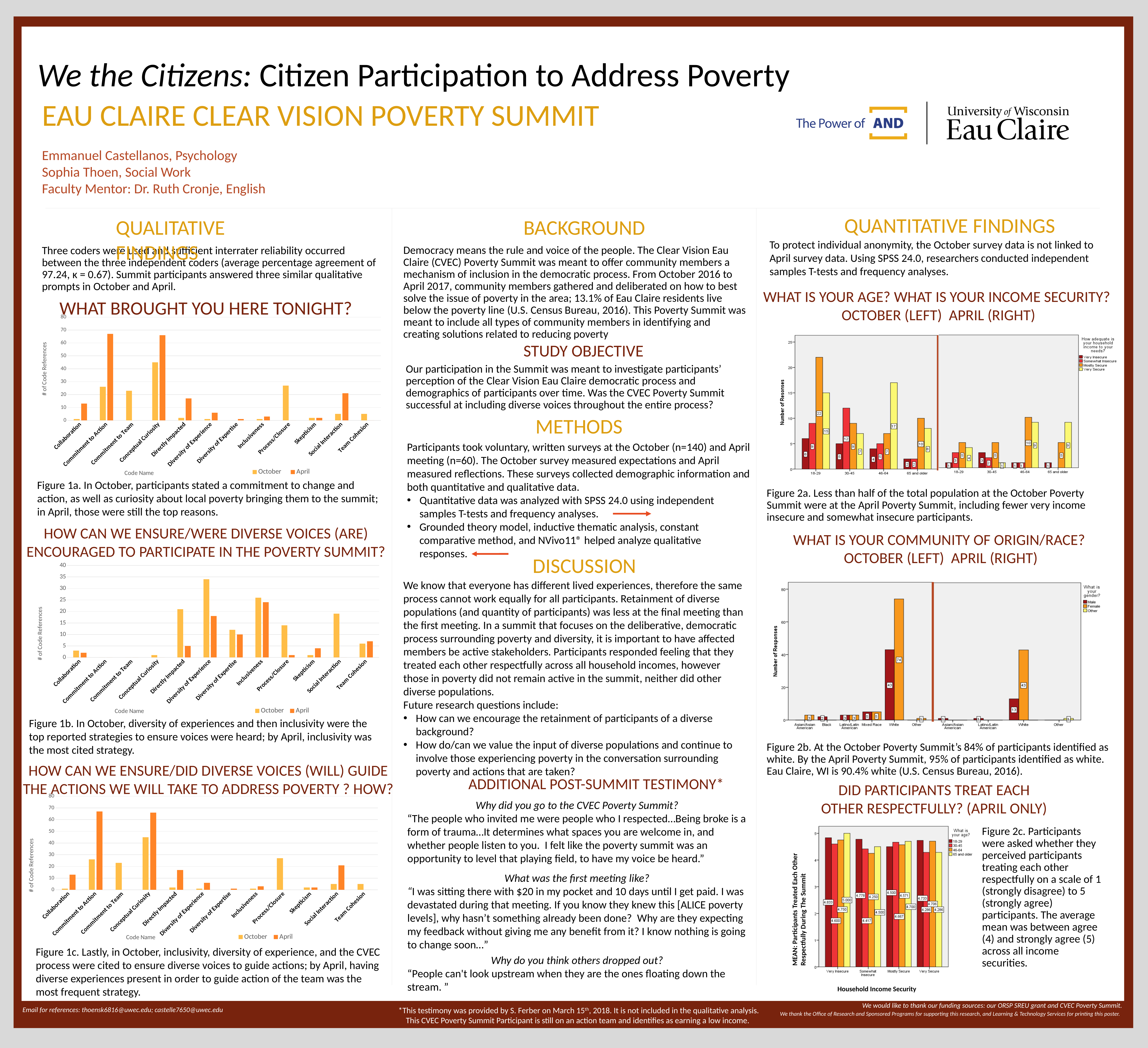
In Figure 2b (community of origin/race), what is the difference between Female and Male responses for White in October? 31 In the chart titled "WHAT BROUGHT YOU HERE TONIGHT?" (Figure 1a), is the April value for Commitment to Action greater or less than 60? greater In the chart titled "WHAT BROUGHT YOU HERE TONIGHT?" (Figure 1a), which category has the highest October value? Conceptual Curiosity In the chart titled "WHAT BROUGHT YOU HERE TONIGHT?" (Figure 1a), how many code name categories are shown on the x axis? 12 In Figure 2c ("DID PARTICIPANTS TREAT EACH OTHER RESPECTFULLY?"), what is the mean for the 65 and older group under Very Insecure? 5.000 What kind of chart is Figure 1c ("HOW CAN WE ENSURE/DID DIVERSE VOICES (WILL) GUIDE THE ACTIONS WE WILL TAKE TO ADDRESS POVERTY? HOW?")? Bar chart In Figure 2a (age and income security), what is the difference between the Mostly Secure and Very Secure responses for the 18-29 group in October? 7 In Figure 1b ("HOW CAN WE ENSURE/WERE DIVERSE VOICES (ARE) ENCOURAGED TO PARTICIPATE IN THE POVERTY SUMMIT?"), is the October value for Diversity of Experience greater or less than 30? greater In Figure 2a (age and income security), what is the number of responses for Mostly Secure in the 18-29 group in October? 22 In Figure 1b ("HOW CAN WE ENSURE/WERE DIVERSE VOICES (ARE) ENCOURAGED TO PARTICIPATE IN THE POVERTY SUMMIT?"), which category has the highest October value? Diversity of Experience In Figure 1b, which is larger for Inclusiveness: the October value or the April value? October In the chart titled "WHAT BROUGHT YOU HERE TONIGHT?" (Figure 1a), how many series does the legend list? 2